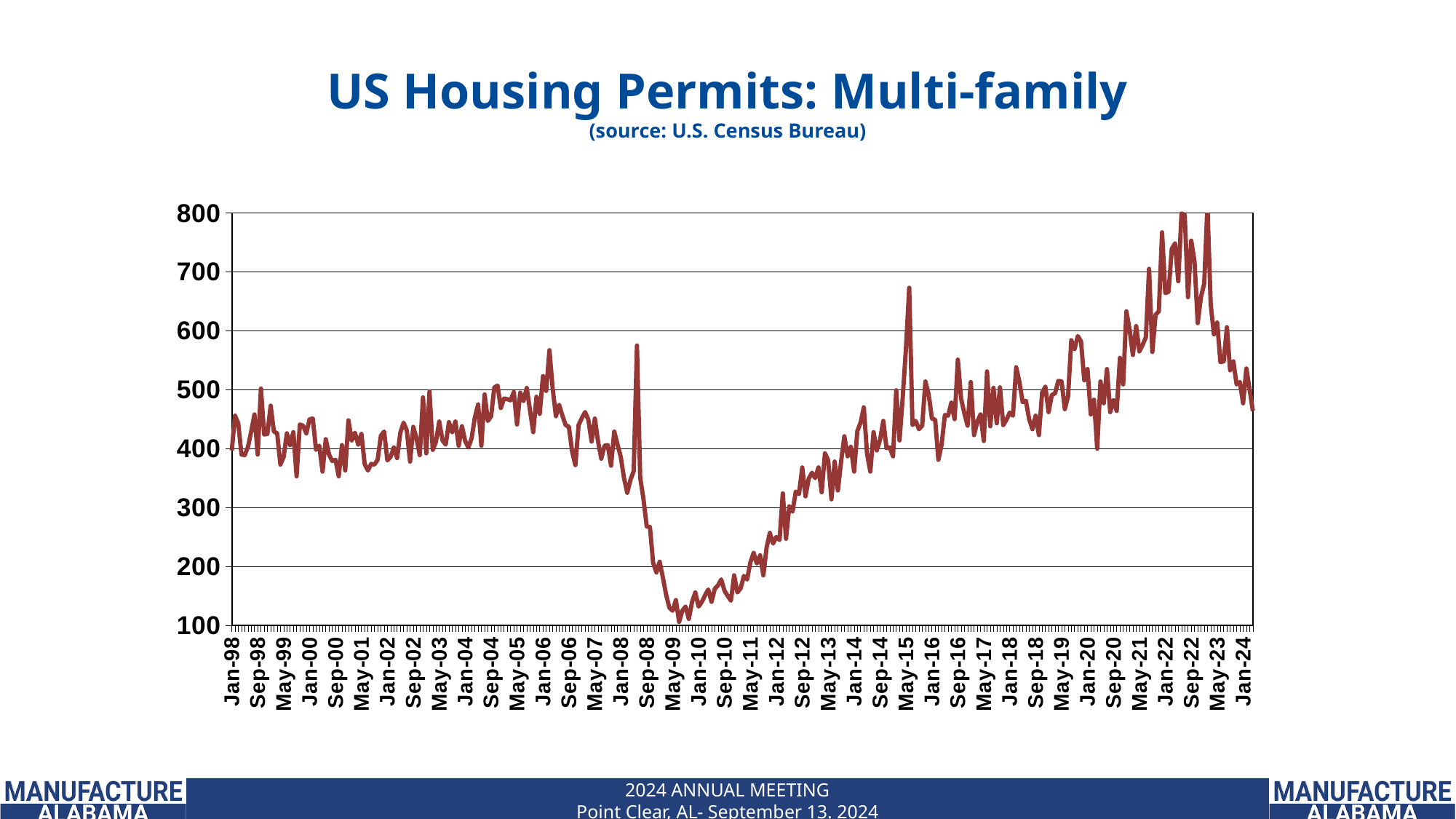
What type of chart is shown on the slide? line chart Is the value at Jan-10 greater or less than 300? less What source is cited for the chart's data? U.S. Census Bureau What is the title of the chart? US Housing Permits: Multi-family Is the value at Jan-24 greater or less than 400? greater Is the value around May-09 greater or less than 200? less Between Sep-22 and Jan-24, does the line generally rise or fall? fall Between May-09 and Jan-14, does the line generally rise or fall? rise Between Jan-06 and Jan-09, does the line generally rise or fall? fall